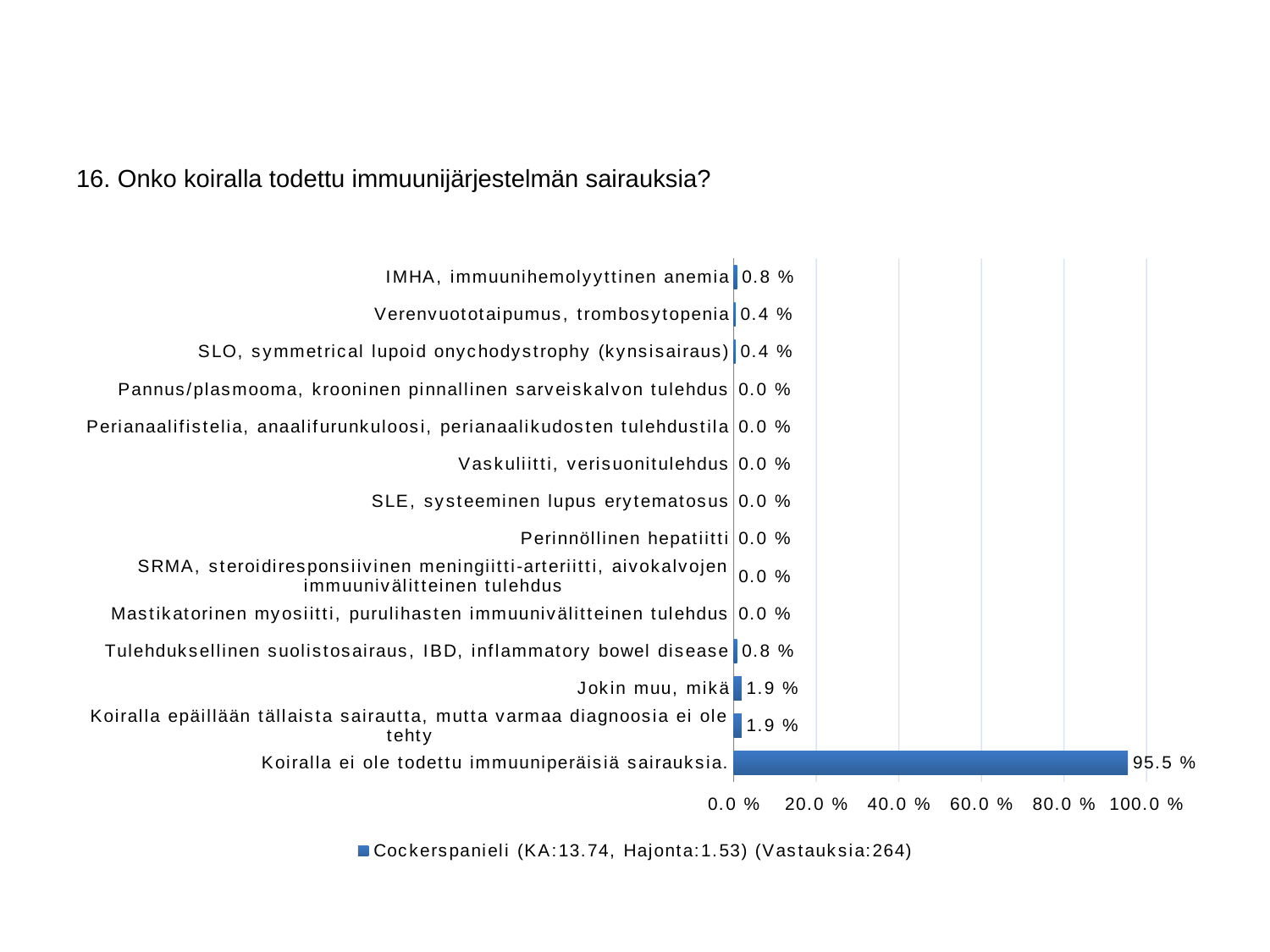
What is the value for "SLO, symmetrical lupoid onychodystrophy (kynsisairaus)"? 0.4 % What is the value for "Koiralla ei ole todettu immuuniperäisiä sairauksia."? 95.5 % How many categories are shown in the chart? 14 What is the difference between the values for "Koiralla ei ole todettu immuuniperäisiä sairauksia." and "Jokin muu, mikä"? 93.6 % Which category has the highest value? Koiralla ei ole todettu immuuniperäisiä sairauksia. Is the value for "Koiralla ei ole todettu immuuniperäisiä sairauksia." greater or less than 80.0 %? greater What is the value for "IMHA, immuunihemolyyttinen anemia"? 0.8 % How many series does the legend list? 1 Which is larger: the value for "IMHA, immuunihemolyyttinen anemia" or the value for "Verenvuototaipumus, trombosytopenia"? IMHA, immuunihemolyyttinen anemia What kind of chart is shown on the slide? bar chart What is the value for "Jokin muu, mikä"? 1.9 % What is the title of the slide? 16. Onko koiralla todettu immuunijärjestelmän sairauksia?